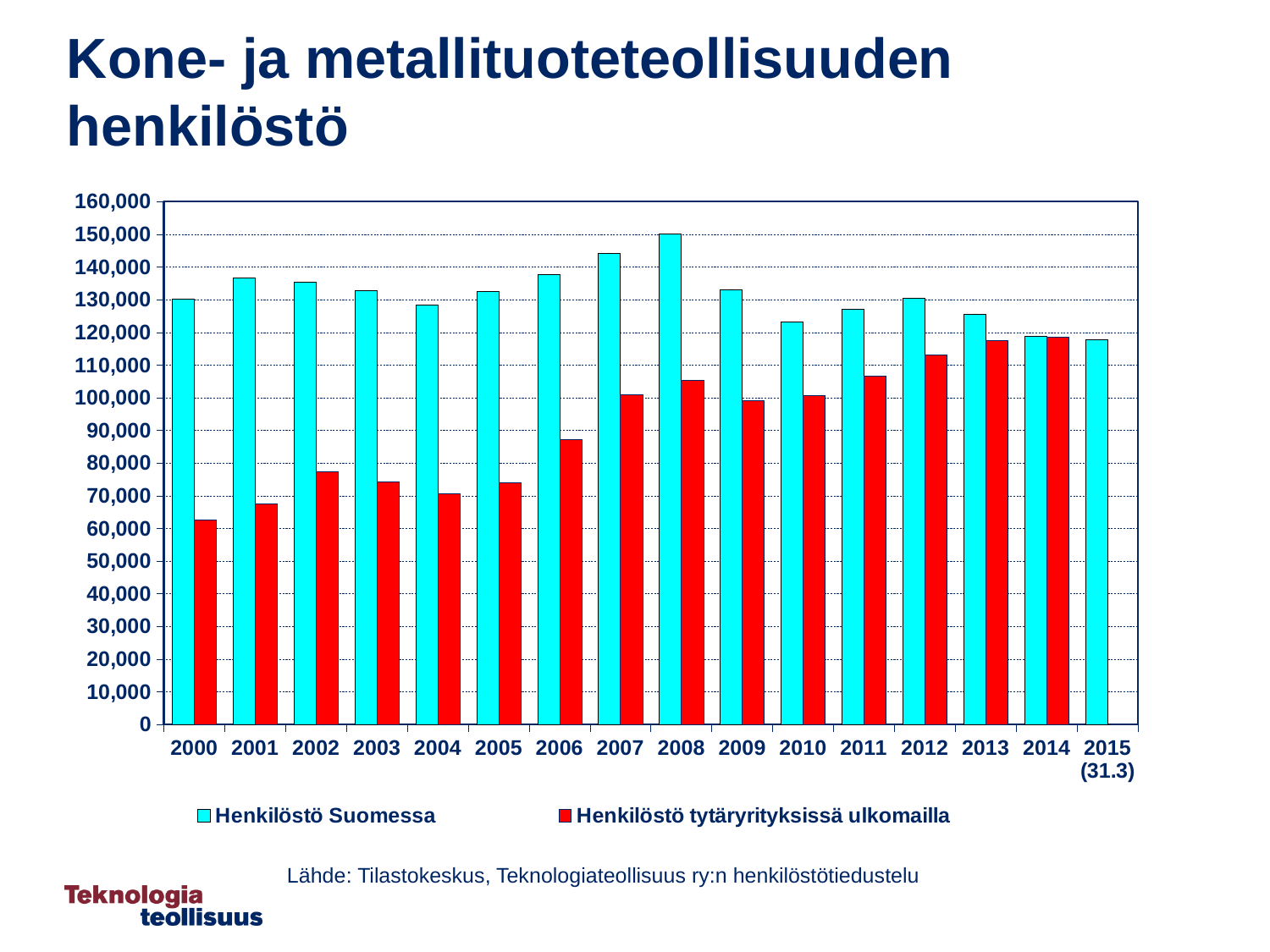
How many series does the legend list? 2 Is the value for Henkilöstö tytäryrityksissä ulkomailla in 2012 greater or less than 110,000? greater Is the value for Henkilöstö Suomessa in 2010 greater or less than 120,000? greater In which year is Henkilöstö tytäryrityksissä ulkomailla lowest? 2000 In which year is Henkilöstö Suomessa highest? 2008 How many years are shown on the x axis? 16 Is the value for Henkilöstö Suomessa in 2008 greater or less than 140,000? greater Does Henkilöstö tytäryrityksissä ulkomailla generally rise or fall from 2000 to 2014? Rise What kind of chart is shown on the slide? Bar chart Which is larger in 2013: Henkilöstö Suomessa or Henkilöstö tytäryrityksissä ulkomailla? Henkilöstö Suomessa Which colour represents Henkilöstö tytäryrityksissä ulkomailla in the legend? Red